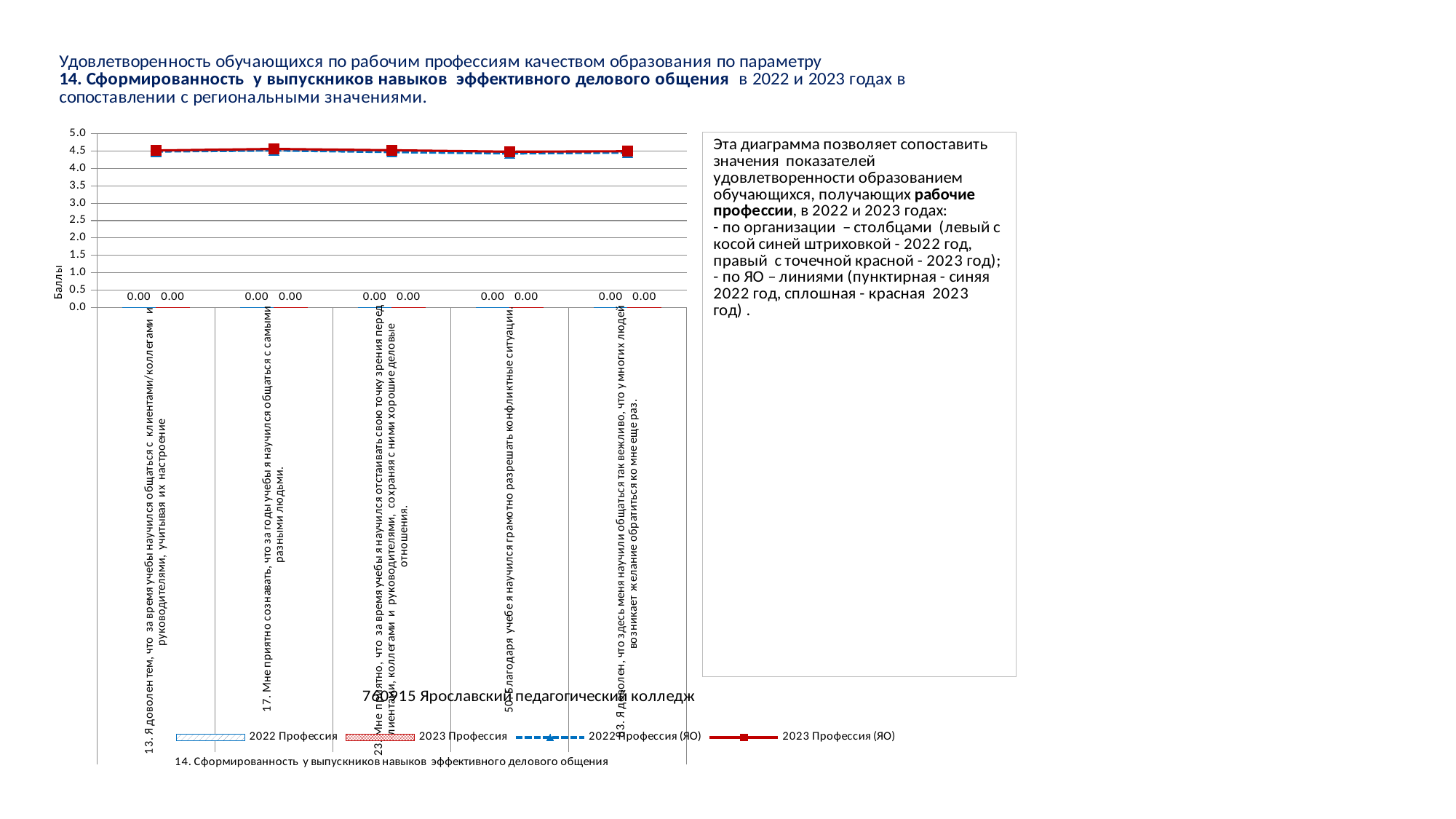
What is the value of the 2022 Профессия bar for category 13 (Я доволен тем, что за время учебы научился общаться с клиентами/коллегами и руководителями)? 0.00 What is the maximum value shown on the vertical axis of the chart? 5.0 Is the value of the 2023 Профессия (ЯО) line for category 23 greater or less than 3.0? greater Is the value of the 2022 Профессия (ЯО) line for category 50 greater or less than 5.0? less What is the title of the vertical axis of the chart? Баллы What kind of chart is shown on the slide? Combined bar and line chart How many categories are shown on the x axis of the chart? 5 How many series does the legend list? 4 What is the value of the 2023 Профессия bar for category 17 (Мне приятно сознавать, что за годы учебы я научился общаться с самыми разными людьми)? 0.00 Is the value of the 2023 Профессия (ЯО) line for category 13 greater or less than 4.0? greater